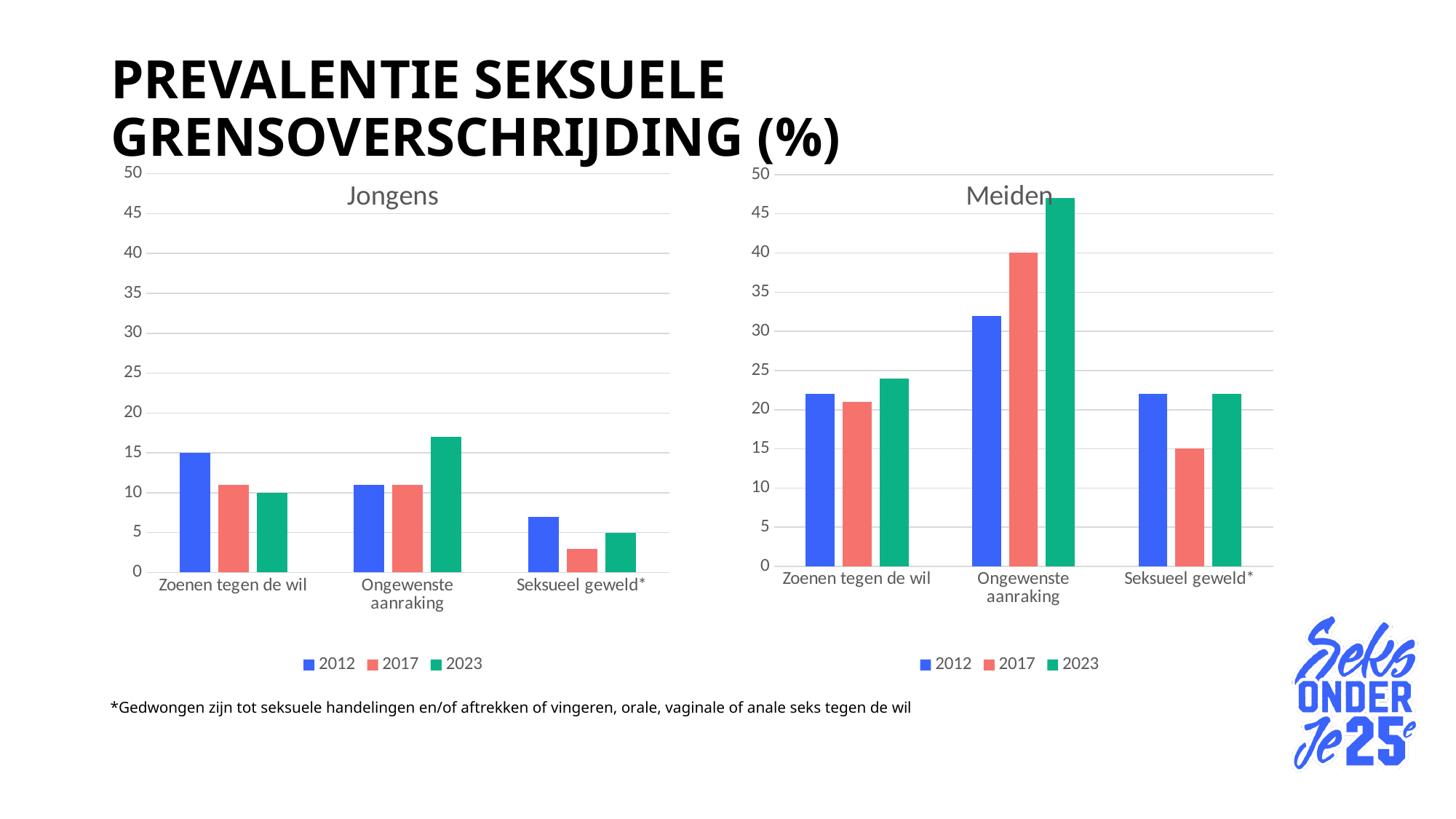
In the Meiden chart, what is the value for Seksueel geweld* in 2017? 15 How many series does the legend of the Meiden chart list? 3 In the Jongens chart, what is the value for Seksueel geweld* in 2023? 5 In the Meiden chart, do the values for Ongewenste aanraking rise or fall from 2012 to 2023? rise In the Meiden chart, is the value for Ongewenste aanraking in 2023 greater or less than 45? greater In the Jongens chart, which category has the lowest bar? Seksueel geweld* In the Jongens chart, what is the value for Zoenen tegen de wil in 2012? 15 In the Meiden chart, what is the value for Ongewenste aanraking in 2017? 40 In the Jongens chart, is the value for Seksueel geweld* in 2017 greater or less than 5? less In the Jongens chart, which is larger for Zoenen tegen de wil: the 2012 value or the 2023 value? 2012 In the Meiden chart, which category has the highest bar? Ongewenste aanraking In the Meiden chart, what is the difference between the 2017 values for Ongewenste aanraking and Seksueel geweld*? 25